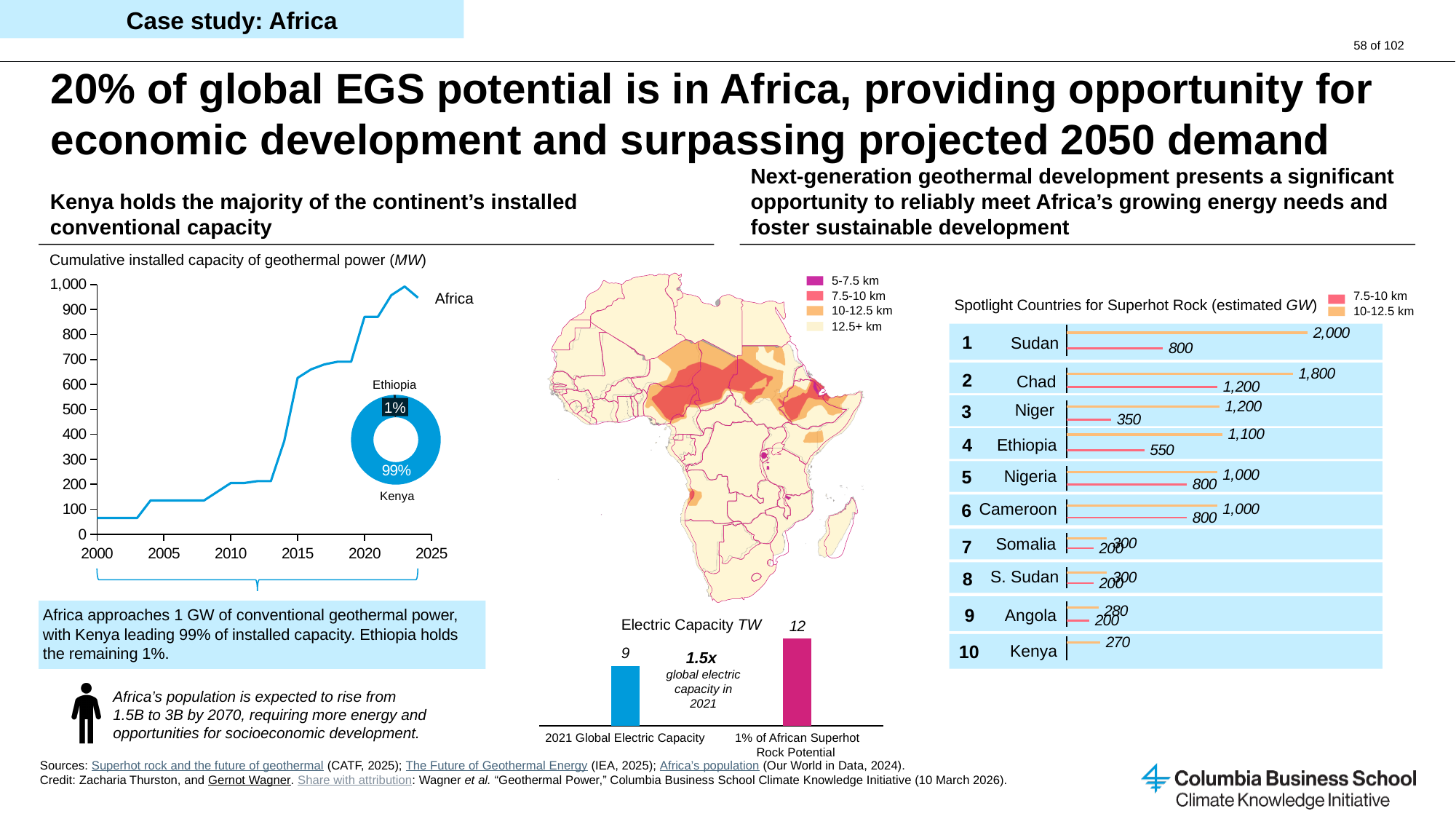
In the 'Spotlight Countries for Superhot Rock' chart, how many series does the legend list? 2 In the 'Spotlight Countries for Superhot Rock' chart, what is the 10-12.5 km value for Sudan? 2,000 In the donut chart of installed conventional capacity, what share does Ethiopia hold? 1% In the 'Electric Capacity TW' bar chart, what is the value for '1% of African Superhot Rock Potential'? 12 In the donut chart of installed conventional capacity, what share does Kenya hold? 99% In the 'Cumulative installed capacity of geothermal power' line chart, is the value for Africa in 2020 greater or less than 800? greater In the 'Spotlight Countries for Superhot Rock' chart, how many countries are listed? 10 In the 'Electric Capacity TW' bar chart, what is the difference between the two bars? 3 In the 'Spotlight Countries for Superhot Rock' chart, what is the difference between Chad's 10-12.5 km value and its 7.5-10 km value? 600 In the 'Spotlight Countries for Superhot Rock' chart, which country has the highest 10-12.5 km value? Sudan In the 'Spotlight Countries for Superhot Rock' chart, what is the 7.5-10 km value for Niger? 350 In the 'Electric Capacity TW' bar chart, what is the value for '2021 Global Electric Capacity'? 9